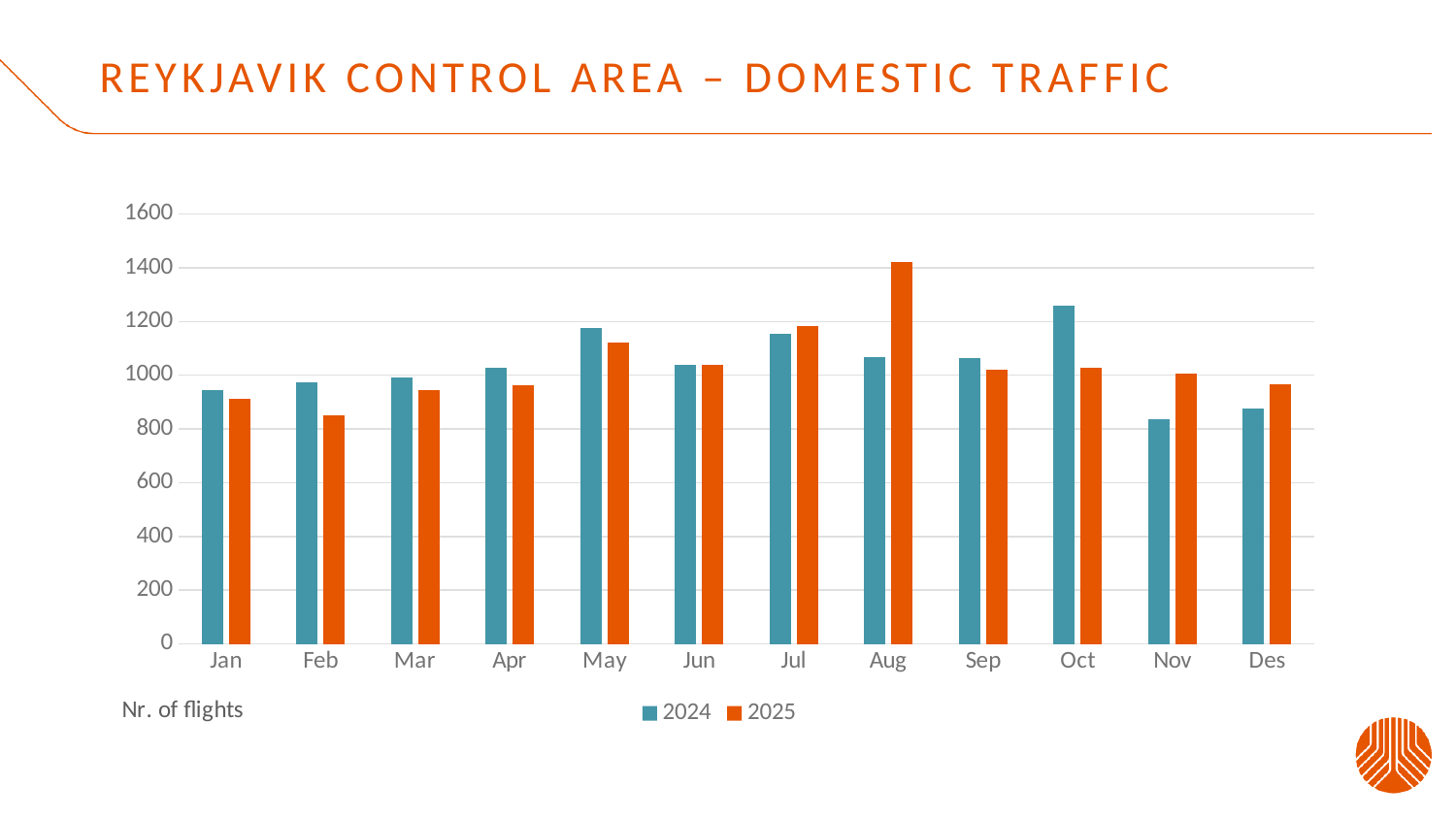
In which month is the 2024 value lowest? Nov What type of chart is shown on the slide? Bar chart How many months are shown on the x axis? 12 In which month is the 2024 value highest? Oct What is the title of the chart on the slide? REYKJAVIK CONTROL AREA – DOMESTIC TRAFFIC Is the 2024 value for Nov greater or less than 1000? less How many series does the legend list? 2 In Aug, which series has the larger value, 2024 or 2025? 2025 In which month is the 2025 value lowest? Feb In which month is the 2025 value highest? Aug In Oct, which series has the larger value, 2024 or 2025? 2024 Is the 2025 value for Aug greater or less than 1200? greater